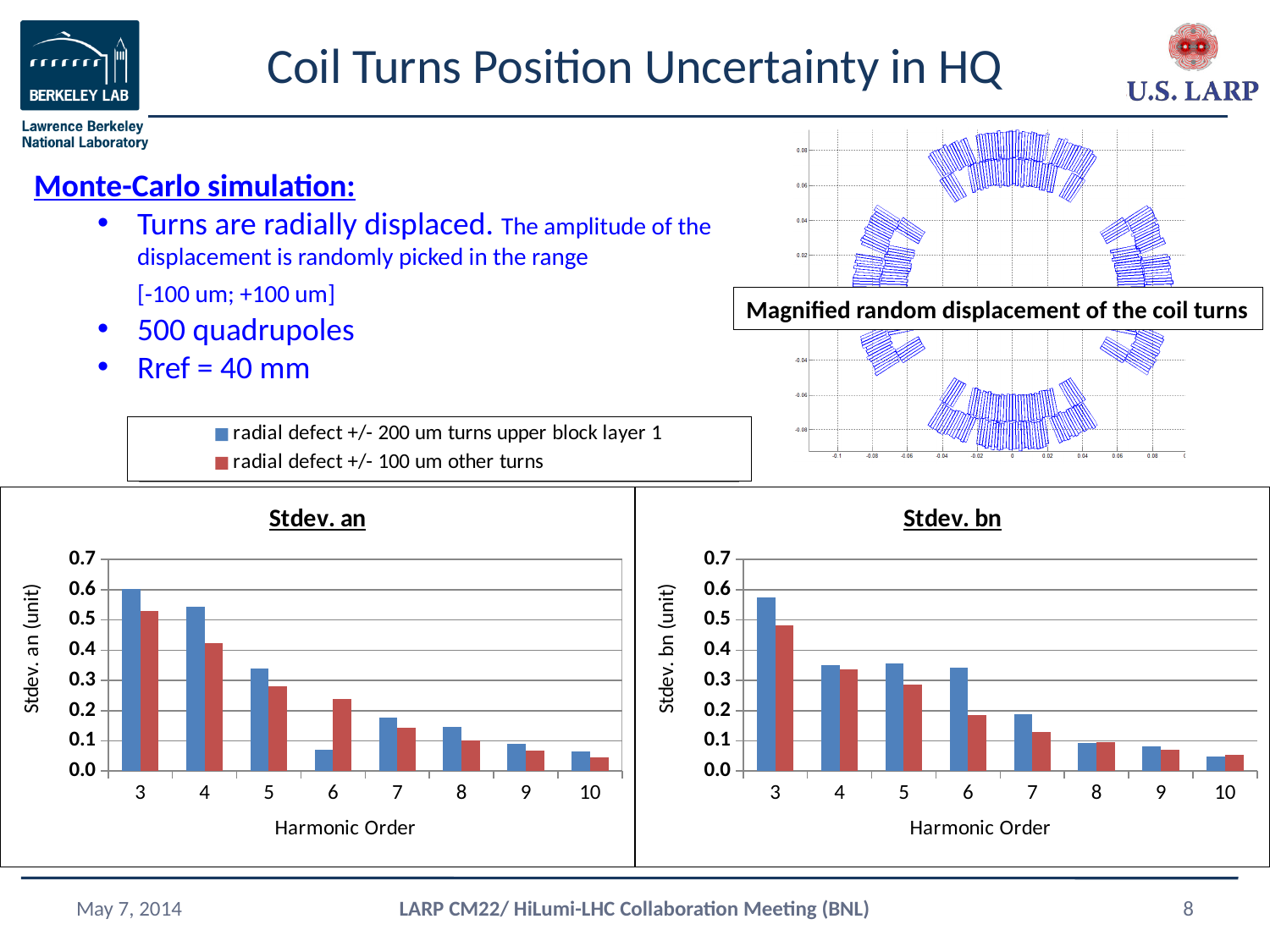
Which colour represents the "radial defect +/- 100 um other turns" series in the charts? red In the "Stdev. an" chart, which harmonic order has the highest value for the "radial defect +/- 200 um turns upper block layer 1" series? 3 How many harmonic orders are shown on the x axis of the "Stdev. bn" chart? 8 In the "Stdev. bn" chart, at harmonic order 3, which series has the larger value? radial defect +/- 200 um turns upper block layer 1 How many series does the legend above the two charts list? 2 In the "Stdev. an" chart, do the values of the "radial defect +/- 100 um other turns" series rise or fall as the harmonic order increases? fall What is the x-axis title of the "Stdev. bn" chart? Harmonic Order In the "Stdev. an" chart, is the value for harmonic order 3 in the "radial defect +/- 200 um turns upper block layer 1" series greater or less than 0.5? greater What kind of chart is the "Stdev. an" chart? bar chart In the "Stdev. bn" chart, is the value for harmonic order 7 in the "radial defect +/- 100 um other turns" series greater or less than 0.2? less In the "Stdev. bn" chart, which harmonic order has the lowest value for the "radial defect +/- 200 um turns upper block layer 1" series? 10 In the "Stdev. an" chart, at harmonic order 6, which series has the larger value? radial defect +/- 100 um other turns